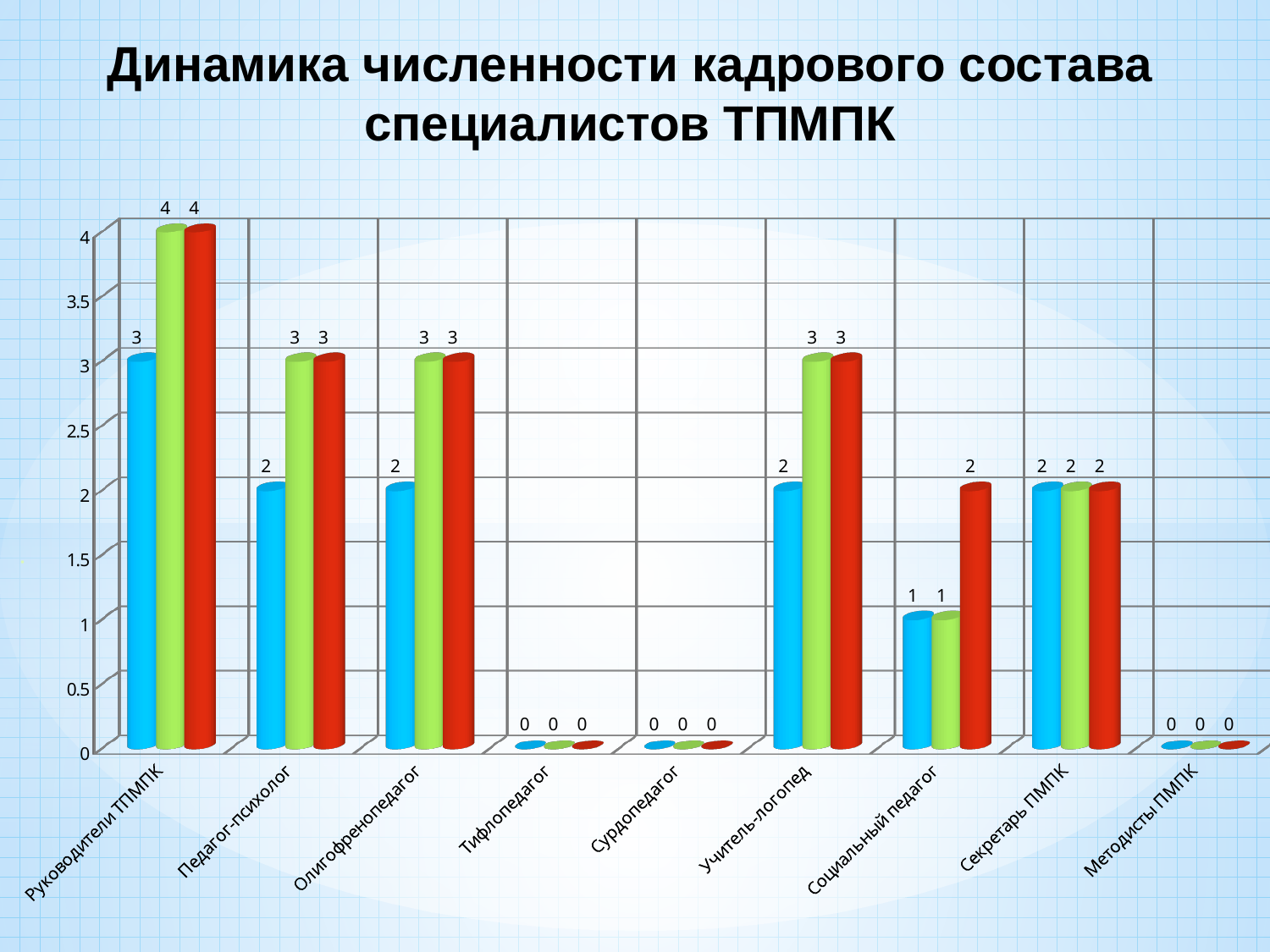
How many categories have all three bars equal to 0? 3 What is the value of the blue bar for Руководители ТПМПК? 3 Which is larger: the blue bar for Олигофренопедагог or the blue bar for Социальный педагог? Олигофренопедагог What is the difference between the red bar and the blue bar for Педагог-психолог? 1 How many categories are shown on the x axis? 9 What is the difference between the green bar for Руководители ТПМПК and the green bar for Секретарь ПМПК? 2 Which category has the highest value among the green bars? Руководители ТПМПК What kind of chart is shown on the slide? bar chart How many bars are shown for each category? 3 What is the value of the green bar for Учитель-логопед? 3 What is the value of the red bar for Социальный педагог? 2 What is the title of the chart? Динамика численности кадрового состава специалистов ТПМПК